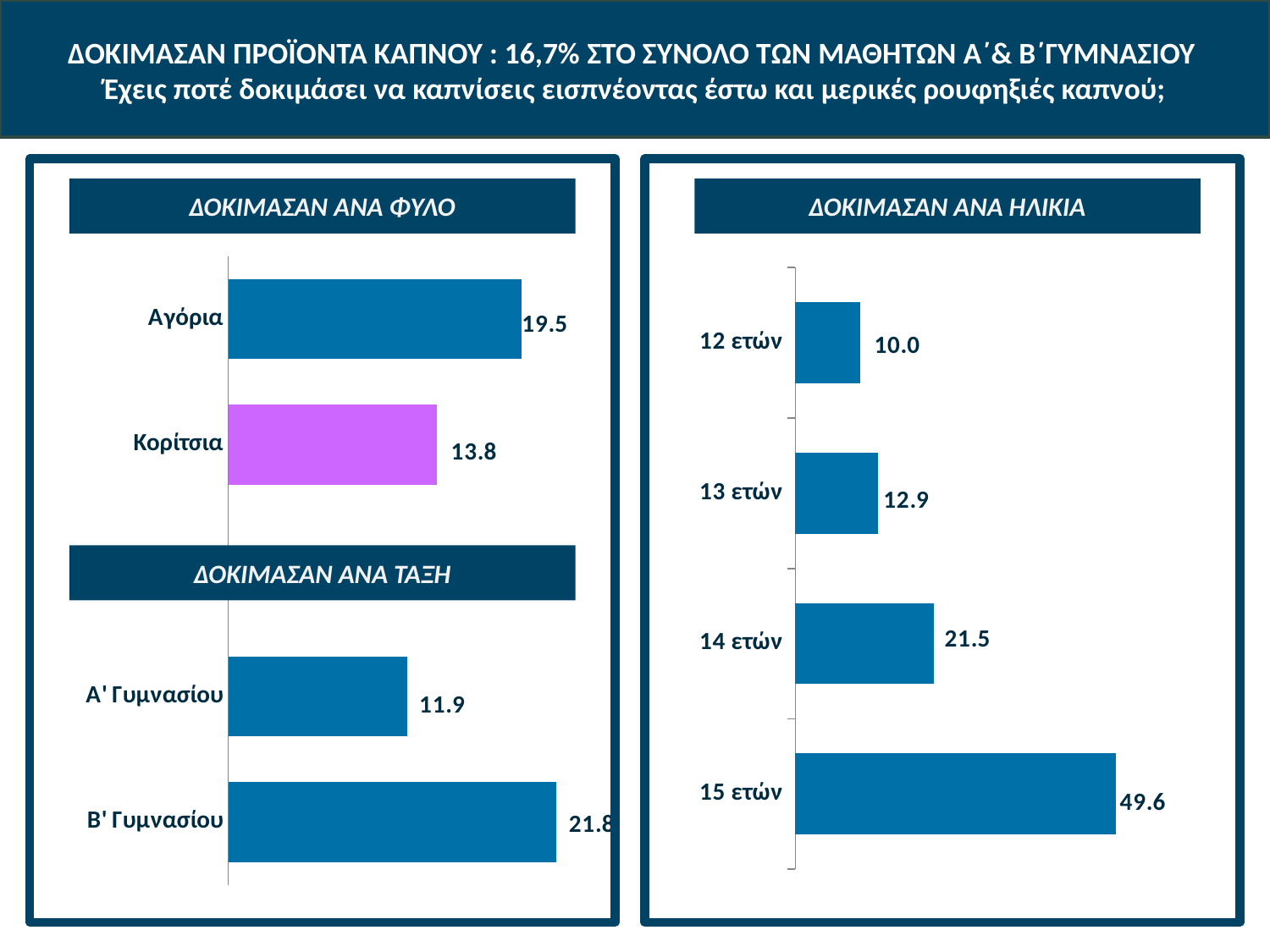
In the chart titled ΔΟΚΙΜΑΣΑΝ ΑΝΑ ΗΛΙΚΙΑ, do the values rise or fall as age increases from 12 ετών to 15 ετών? rise In the chart titled ΔΟΚΙΜΑΣΑΝ ΑΝΑ ΗΛΙΚΙΑ, which age group has the lowest value? 12 ετών In the chart titled ΔΟΚΙΜΑΣΑΝ ΑΝΑ ΗΛΙΚΙΑ, which age group has the highest value? 15 ετών In the chart titled ΔΟΚΙΜΑΣΑΝ ΑΝΑ ΤΑΞΗ, which category has the higher value, Α' Γυμνασίου or Β' Γυμνασίου? Β' Γυμνασίου In the chart titled ΔΟΚΙΜΑΣΑΝ ΑΝΑ ΗΛΙΚΙΑ, what is the value for 14 ετών? 21.5 In the chart titled ΔΟΚΙΜΑΣΑΝ ΑΝΑ ΗΛΙΚΙΑ, how many age categories are shown? 4 What kind of chart is the one titled ΔΟΚΙΜΑΣΑΝ ΑΝΑ ΗΛΙΚΙΑ? bar chart In the chart titled ΔΟΚΙΜΑΣΑΝ ΑΝΑ ΤΑΞΗ, what is the value for Α' Γυμνασίου? 11.9 In the chart titled ΔΟΚΙΜΑΣΑΝ ΑΝΑ ΦΥΛΟ, what is the value for Αγόρια? 19.5 In the chart titled ΔΟΚΙΜΑΣΑΝ ΑΝΑ ΤΑΞΗ, what is the difference between the values for Β' Γυμνασίου and Α' Γυμνασίου? 9.9 In the chart titled ΔΟΚΙΜΑΣΑΝ ΑΝΑ ΦΥΛΟ, what is the difference between the values for Αγόρια and Κορίτσια? 5.7 In the chart titled ΔΟΚΙΜΑΣΑΝ ΑΝΑ ΦΥΛΟ, what is the value for Κορίτσια? 13.8